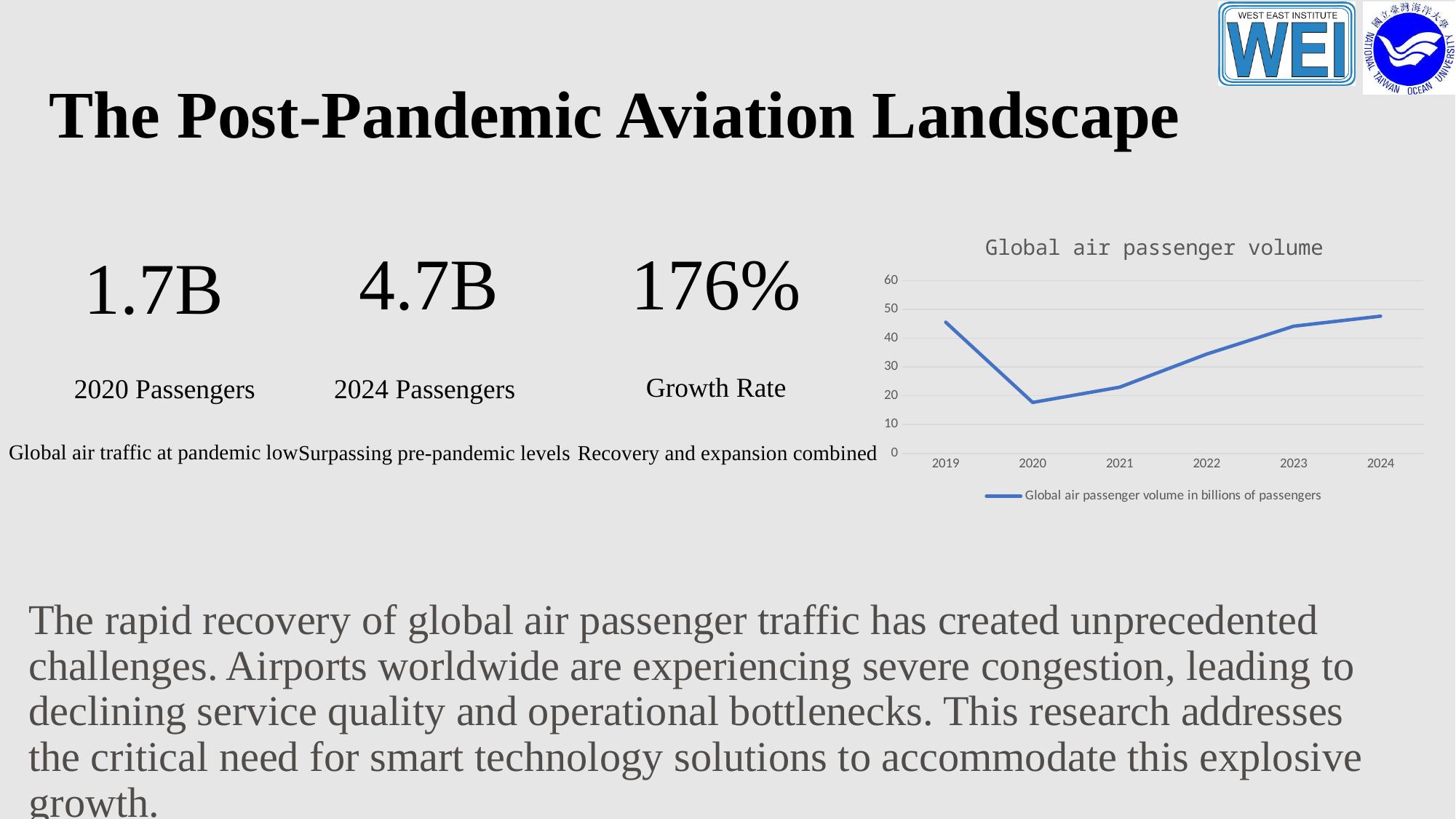
Is the value for 2019 greater or less than 40? greater Which year has a higher global air passenger volume, 2021 or 2023? 2023 Does the global air passenger volume rise or fall from 2020 to 2024? rise How many series does the chart legend list? 1 What is the title of the chart? Global air passenger volume In which year is the global air passenger volume lowest? 2020 How many years are plotted along the x axis of the chart? 6 Is the value for 2022 greater or less than 40? less What kind of chart is shown on the slide? line chart What is the legend entry for the plotted line? Global air passenger volume in billions of passengers Is the value for 2020 greater or less than 20? less In which year is the global air passenger volume highest? 2024